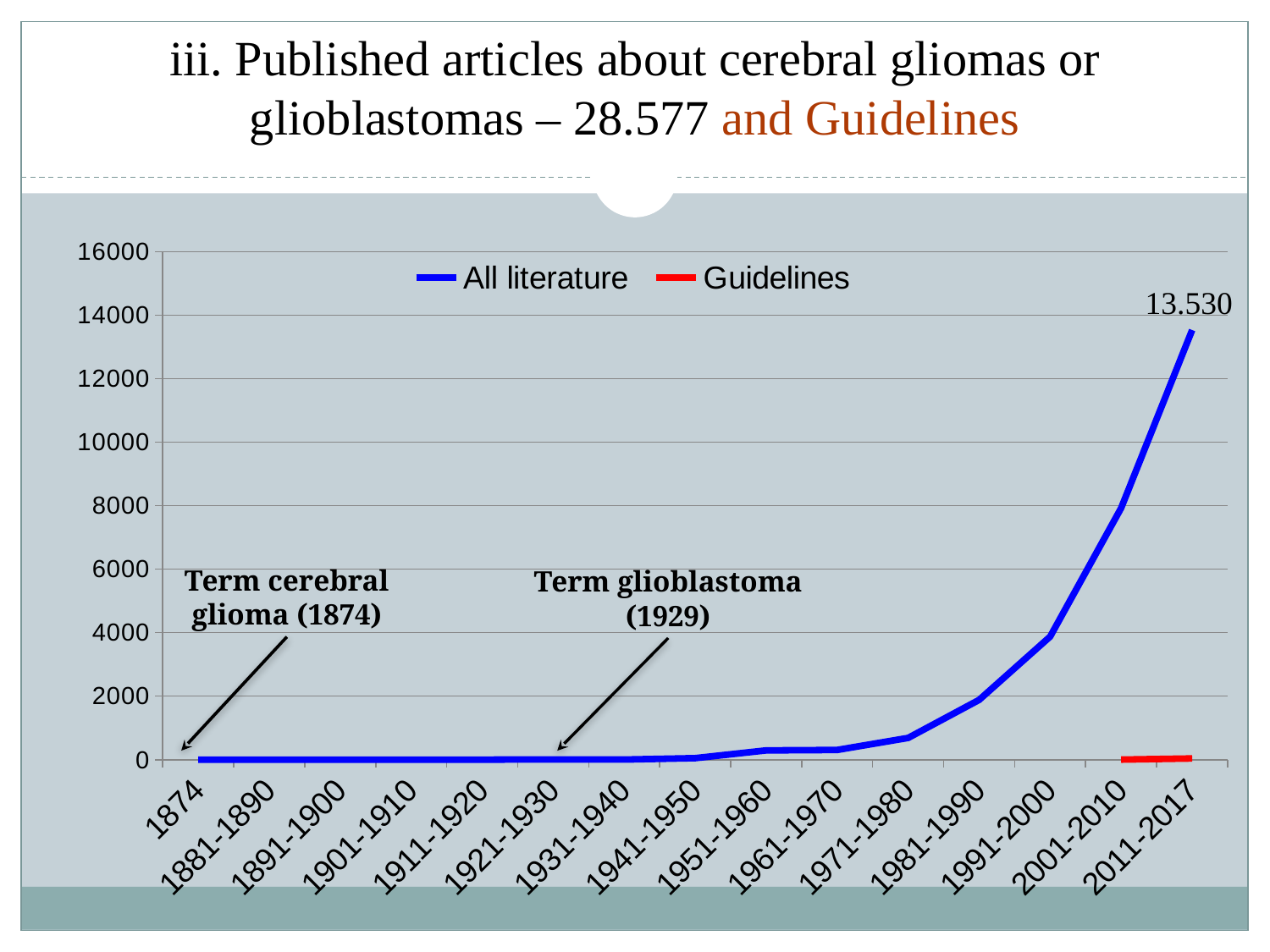
What kind of chart is shown on the slide? line chart Is the value for All literature in 1981-1990 greater or less than 4000? less Is the value for All literature in 2001-2010 greater or less than 6000? greater Does the All literature series rise or fall from 1971-1980 to 2011-2017? rise What colour is the Guidelines series in the legend? red Is the value for Guidelines in 2011-2017 greater or less than 2000? less How many periods are shown on the x axis? 15 Which series is drawn in blue? All literature Which is larger for All literature: 2001-2010 or 1991-2000? 2001-2010 How many series does the legend list? 2 What is the value of All literature for 2011-2017? 13.530 Which period has the highest value for All literature? 2011-2017